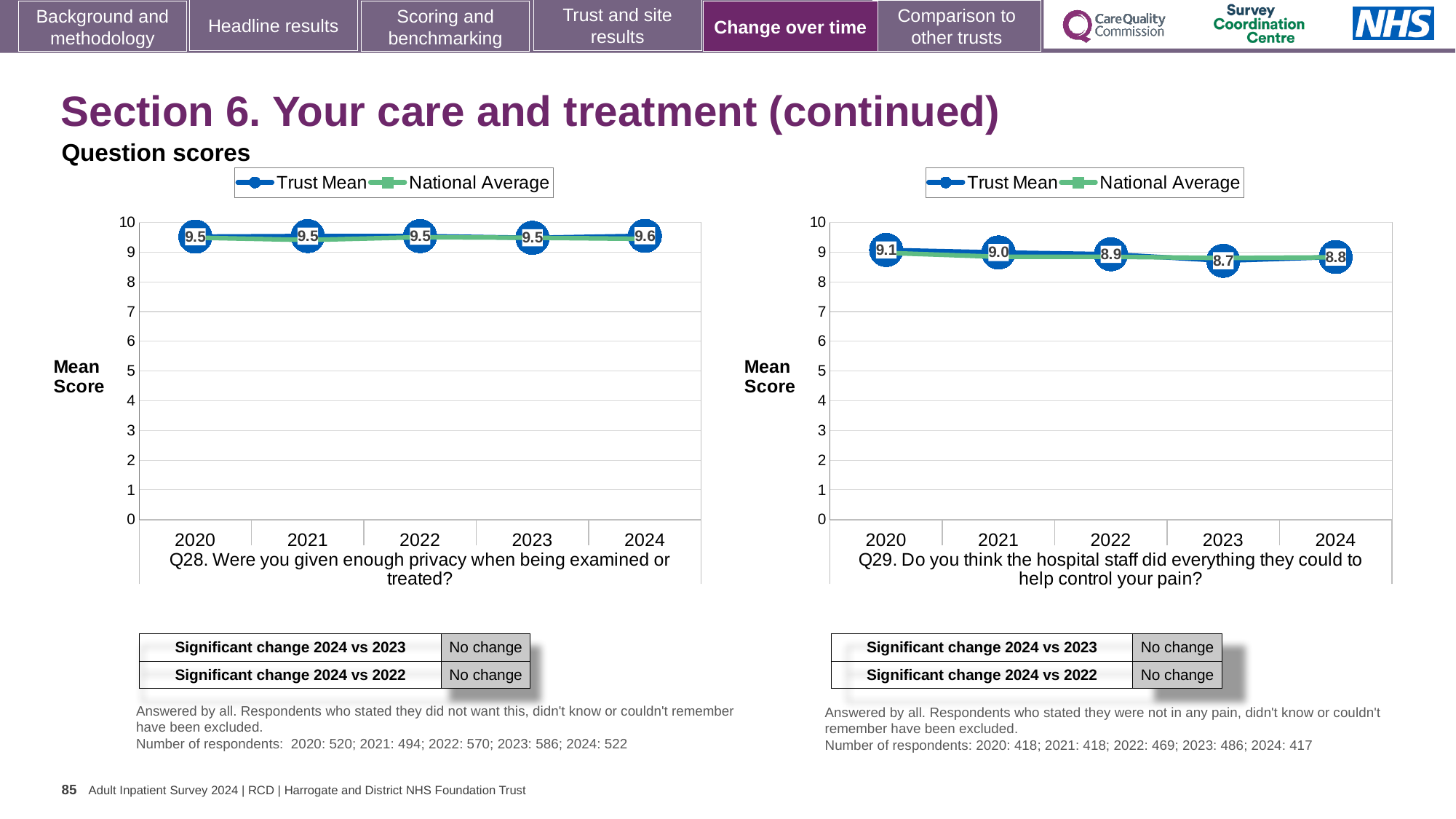
How many series does the legend of the Q29 chart (right) list? 2 In the Q29 chart (right), what is the Trust Mean score for 2023? 8.7 In the Q28 chart (left), what is the Trust Mean score for 2024? 9.6 In the Q29 chart (right), does the Trust Mean score generally rise or fall from 2020 to 2023? fall In the Q28 chart (left), is the Trust Mean score for 2024 larger or smaller than the score for 2023? larger In the Q29 chart (right), is the National Average value for 2024 greater or less than 8? greater In the Q29 chart (right), which year has the lowest Trust Mean score? 2023 In the Q29 chart (right), which year has the highest Trust Mean score? 2020 In the Q29 chart (right), what is the Trust Mean score for 2020? 9.1 How many years are shown on the x axis of the Q28 chart (left)? 5 What kind of chart is the Q28 chart (left)? line chart In the Q29 chart (right), what is the difference between the Trust Mean scores for 2020 and 2023? 0.4